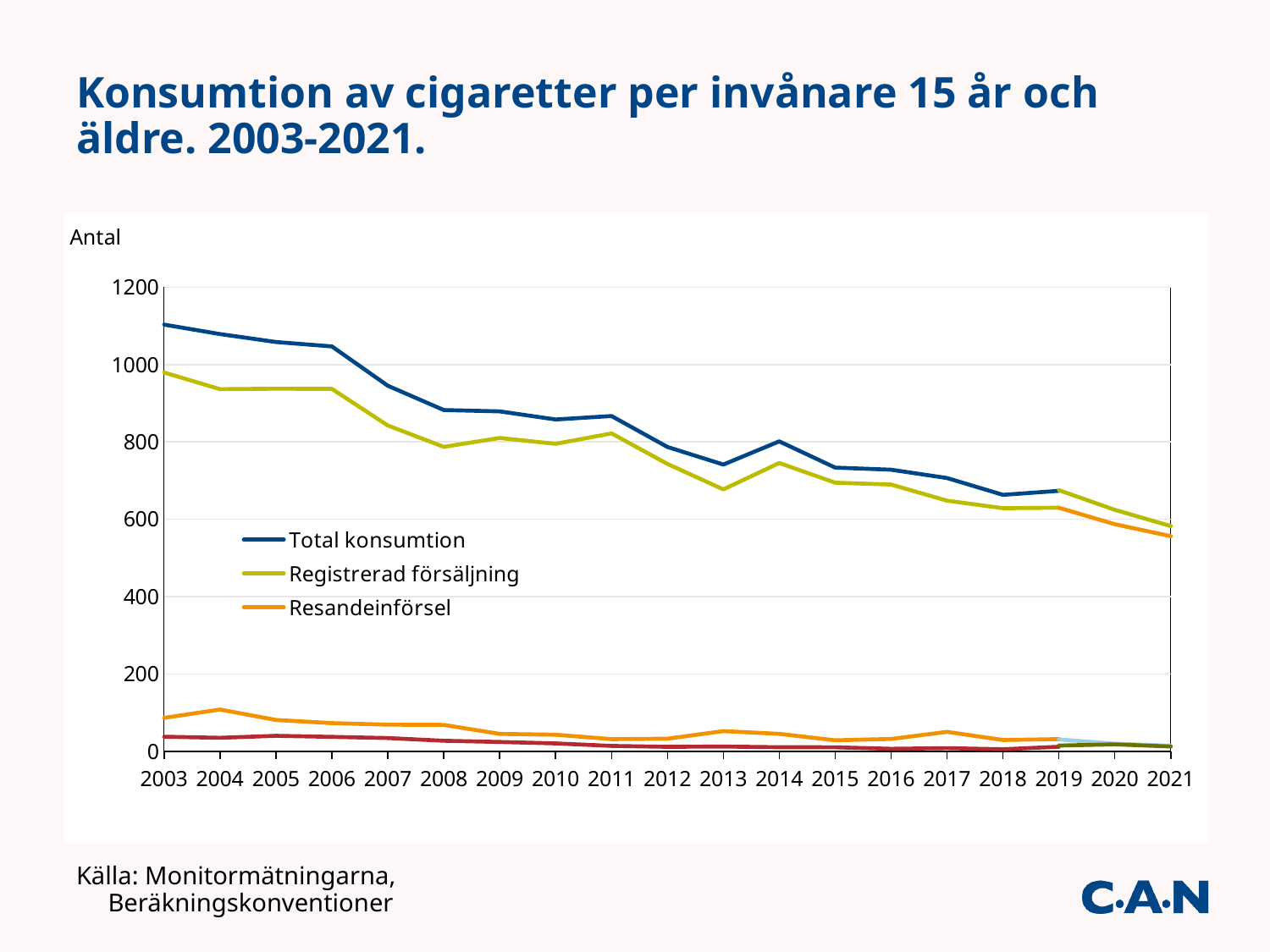
What is the label on the vertical axis of the chart? Antal In which year is Total konsumtion lowest? 2021 Does the Total konsumtion line rise or fall from 2003 to 2021? fall What kind of chart is shown on the slide? line chart In which year is Total konsumtion highest? 2003 Is the value for Registrerad försäljning in 2004 greater or less than 1000? less Is the value for Total konsumtion in 2018 greater or less than 600? greater How many years are plotted along the x axis? 19 How many series does the legend list? 3 Is the value for Total konsumtion in 2003 greater or less than 1000? greater In 2010, which is larger: Total konsumtion or Registrerad försäljning? Total konsumtion